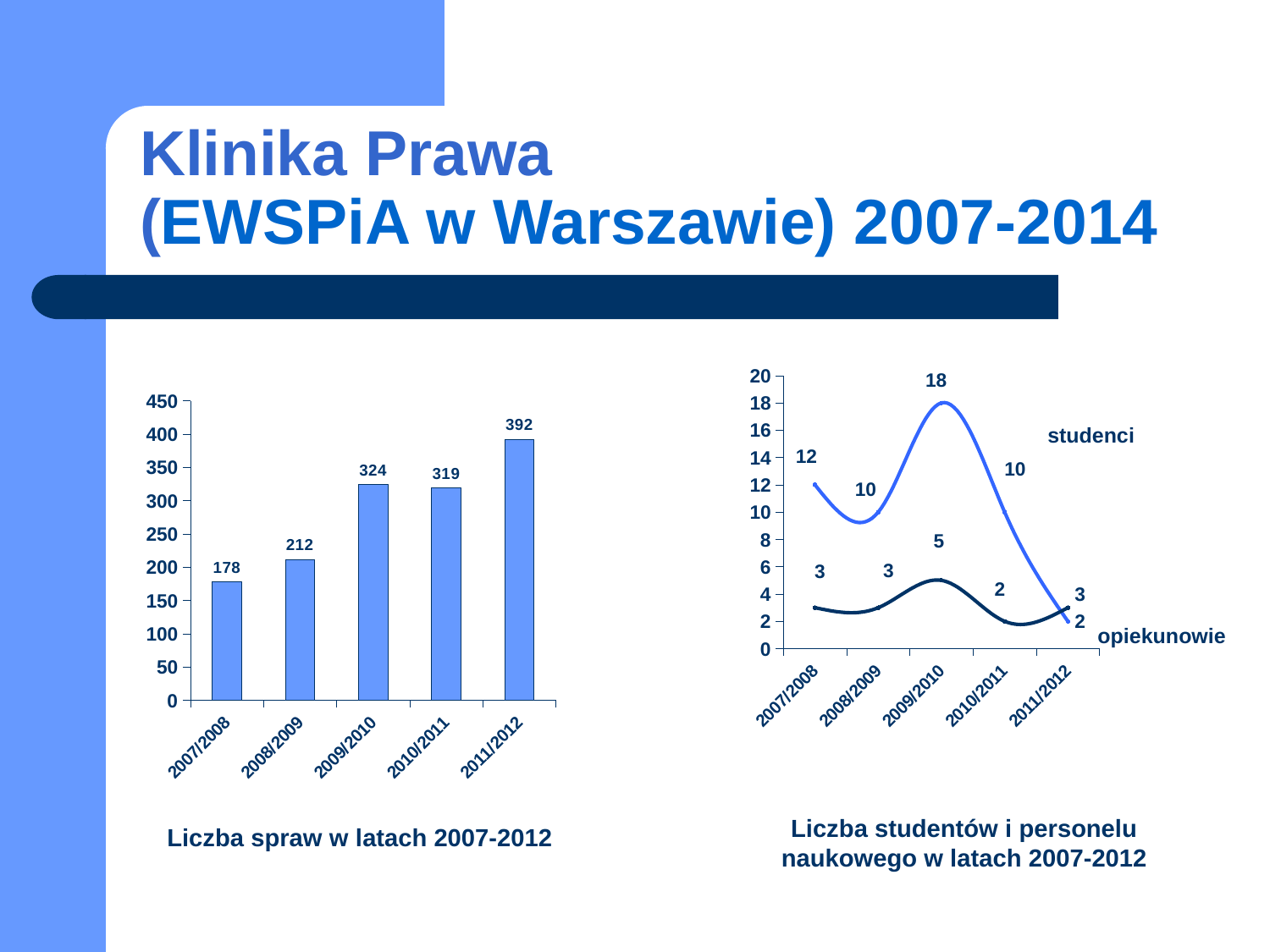
In the left chart (Liczba spraw w latach 2007-2012), what is the value for 2009/2010? 324 In the left chart (Liczba spraw w latach 2007-2012), which year has the highest value? 2011/2012 What kind of chart is the right chart (Liczba studentów i personelu naukowego)? line chart In the right chart (Liczba studentów i personelu naukowego), what is the difference between studenci and opiekunowie in 2007/2008? 9 In the right chart (Liczba studentów i personelu naukowego), how many series are plotted? 2 In the left chart (Liczba spraw w latach 2007-2012), which year has the lowest value? 2007/2008 In the left chart (Liczba spraw w latach 2007-2012), which is larger, the value for 2009/2010 or 2010/2011? 2009/2010 What kind of chart is the left chart (Liczba spraw w latach 2007-2012)? bar chart In the right chart (Liczba studentów i personelu naukowego), what is the value for opiekunowie in 2010/2011? 2 In the left chart (Liczba spraw w latach 2007-2012), how many years are shown on the x axis? 5 In the left chart (Liczba spraw w latach 2007-2012), what is the difference between the values for 2011/2012 and 2007/2008? 214 In the right chart (Liczba studentów i personelu naukowego), what is the value for studenci in 2009/2010? 18